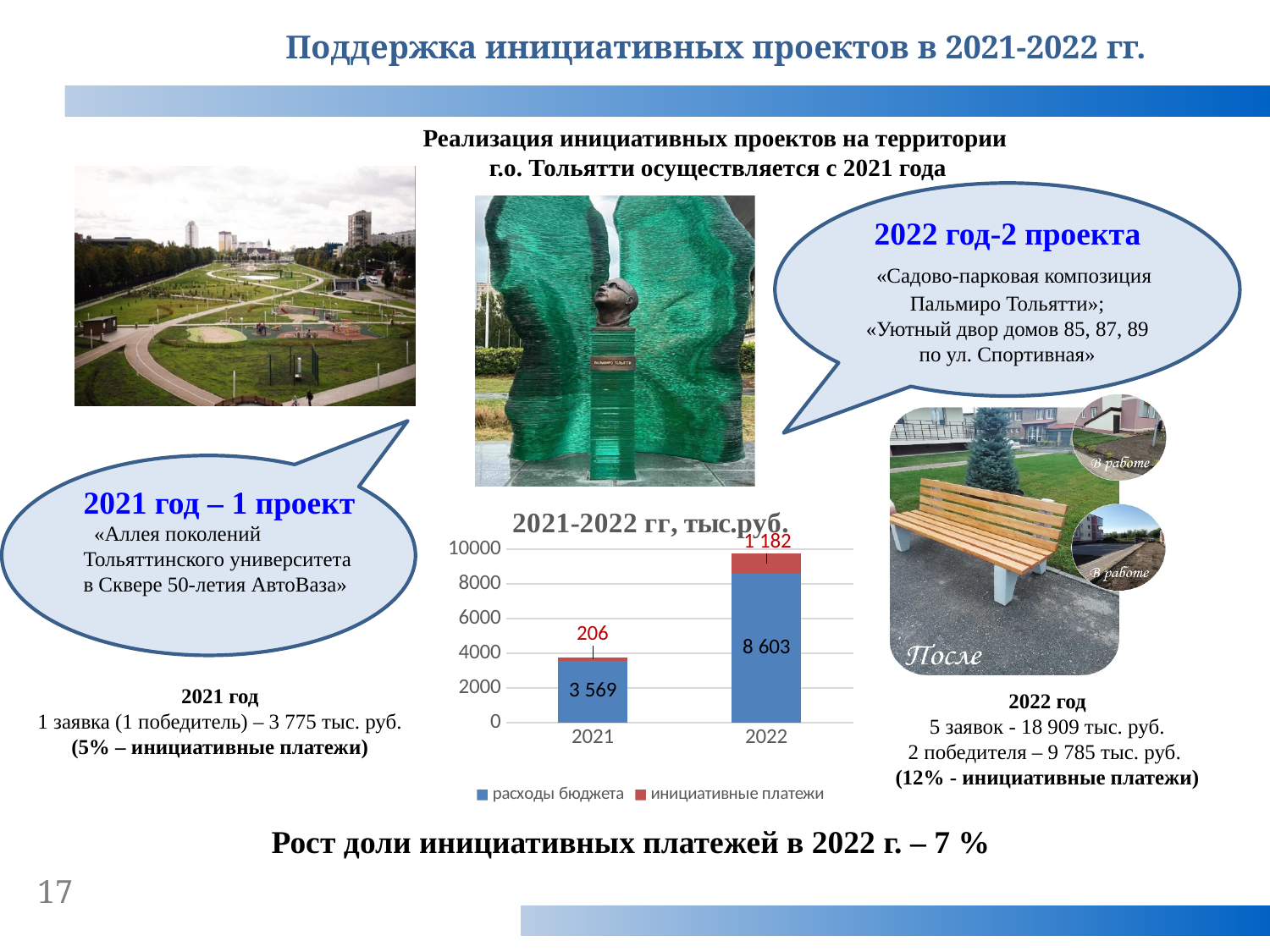
What is the value of расходы бюджета for 2022? 8 603 Which year has the higher value of расходы бюджета? 2022 Which colour represents инициативные платежи in the chart? red What is the title of the chart? 2021-2022 гг, тыс.руб. How many series does the chart legend list? 2 What is the total of the stacked bar for 2022? 9 785 How many categories are shown on the x axis of the chart? 2 What is the value of инициативные платежи for 2022? 1 182 What type of chart is shown on the slide? stacked bar chart What is the value of инициативные платежи for 2021? 206 What is the difference between расходы бюджета in 2022 and in 2021? 5 034 What is the value of расходы бюджета for 2021? 3 569